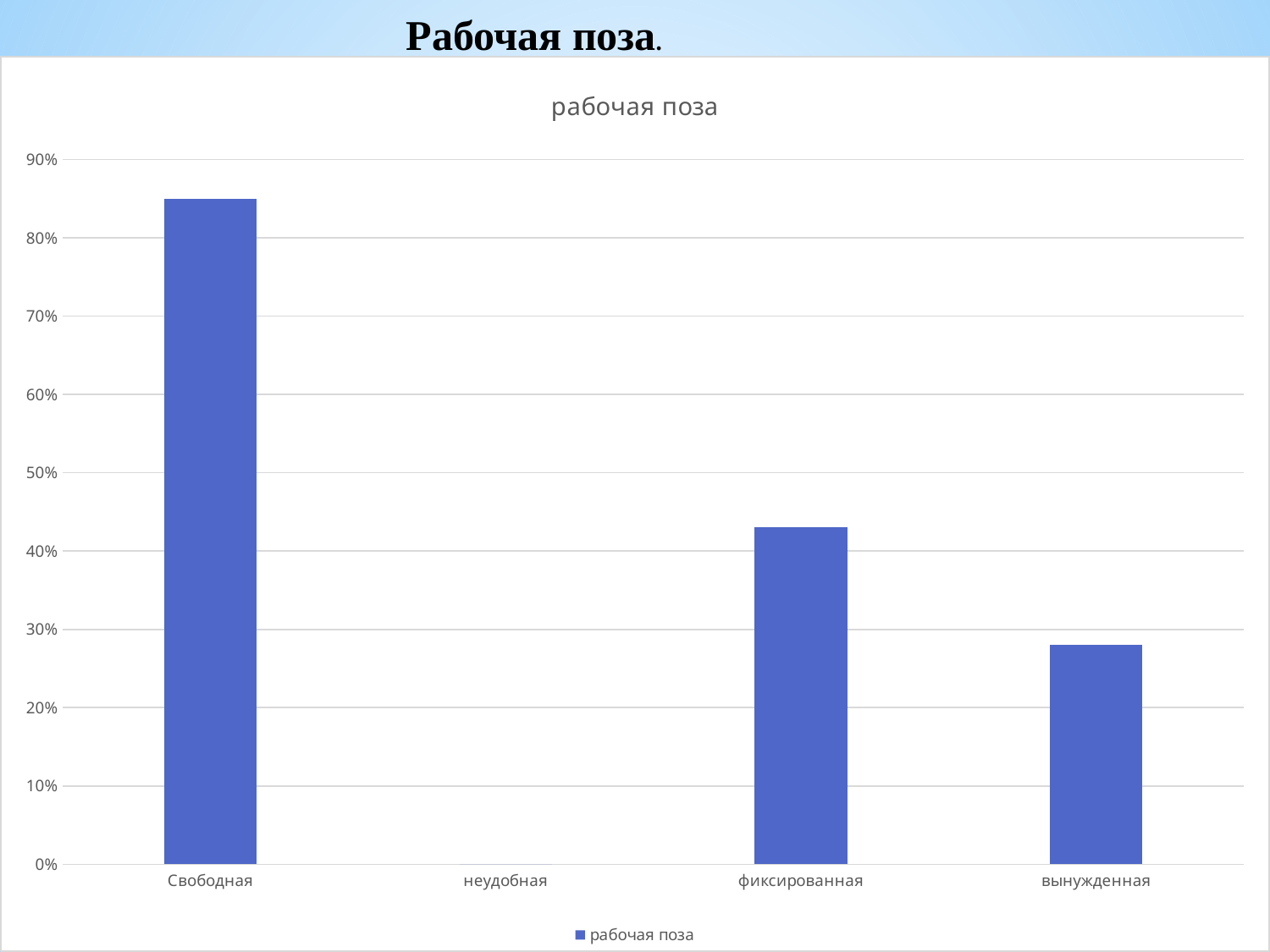
Is the value for вынужденная greater or less than 30%? less How many categories are shown on the x axis of the chart? 4 What is the title of the chart? рабочая поза Which is larger, the value for Свободная or the value for фиксированная? Свободная Is the value for фиксированная greater or less than 40%? greater Is the value for Свободная greater or less than 80%? greater Which category has the highest bar? Свободная How many series does the legend list? 1 Which is larger, the value for фиксированная or the value for вынужденная? фиксированная What is the name of the series listed in the legend? рабочая поза What kind of chart is shown on the slide? bar chart